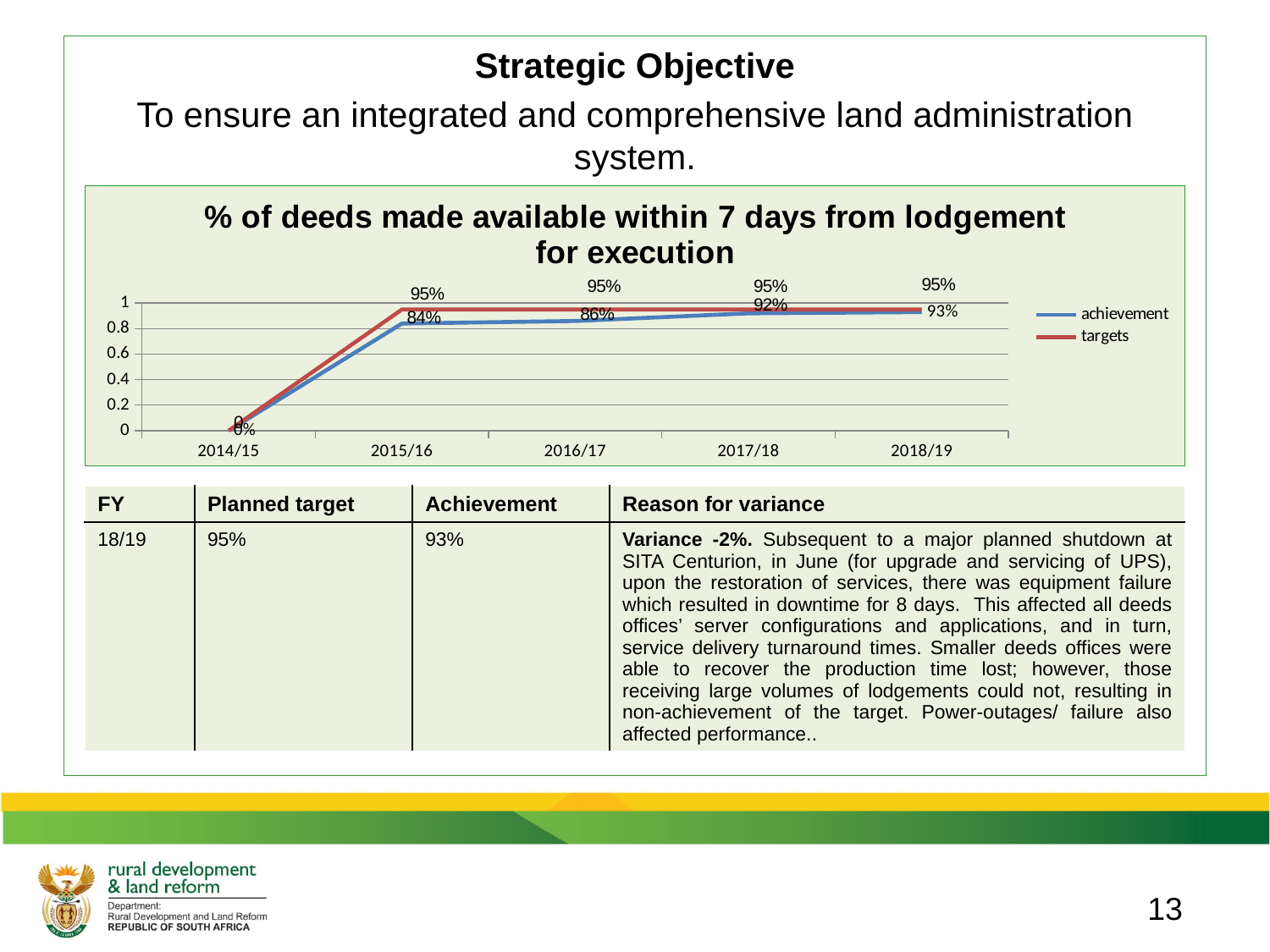
What is the achievement value for 2016/17? 86% What is the achievement value for 2018/19? 93% How many series does the chart legend list? 2 What is the difference between the target and the achievement in 2018/19? 2% Which is larger in 2017/18, the target or the achievement? targets What is the target value for 2017/18? 95% What is the achievement value for 2015/16? 84% How many financial years are shown on the x axis of the chart? 5 What is the title of the chart? % of deeds made available within 7 days from lodgement for execution Does the achievement series rise or fall from 2015/16 to 2018/19? rise What type of chart is shown on the slide? line chart Which year has the highest achievement value? 2018/19